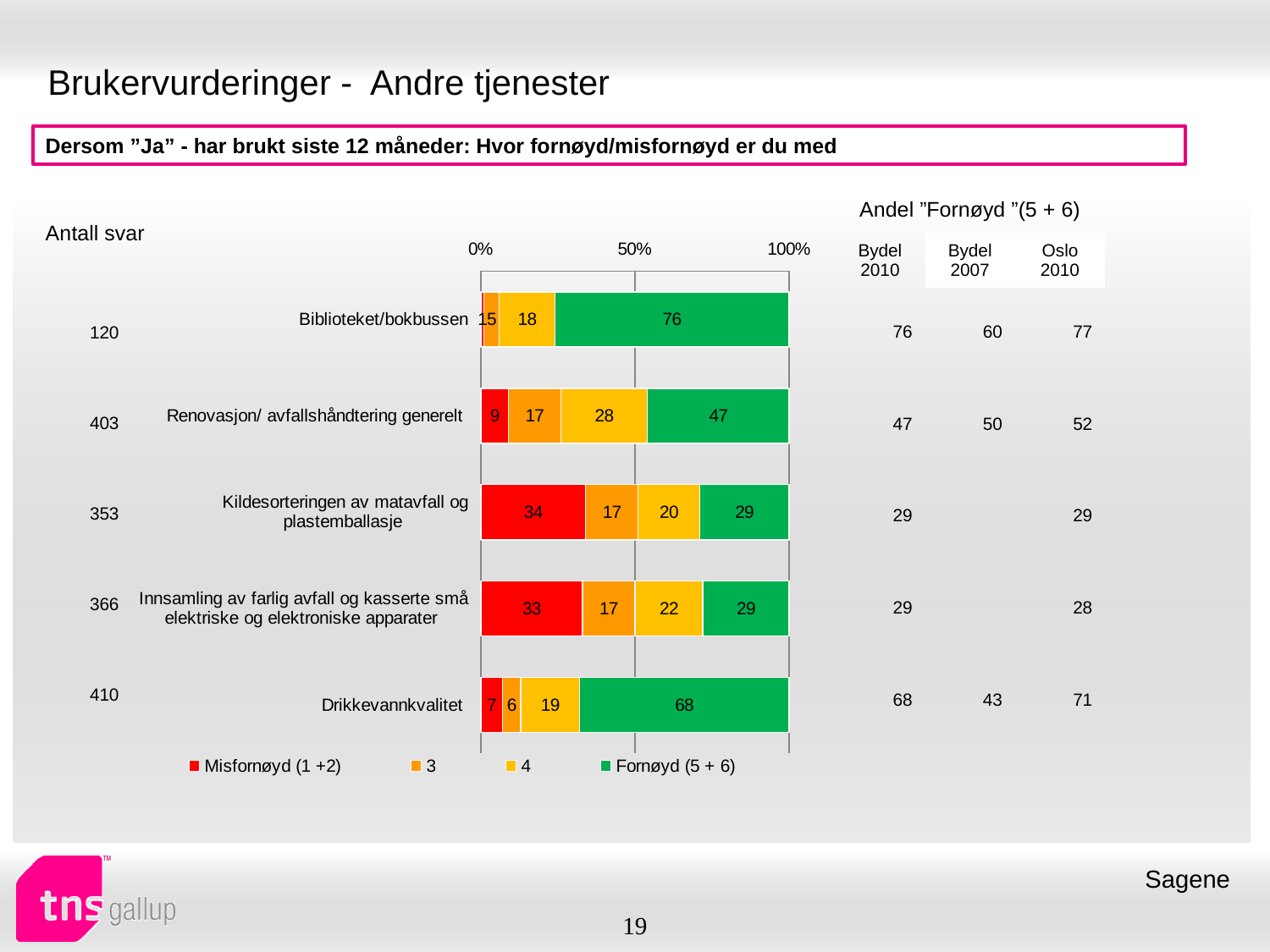
What is the value of the "4" series for Renovasjon/ avfallshåndtering generelt? 28 What kind of chart is shown on the slide? Stacked bar chart Which is larger: the "Fornøyd (5 + 6)" value for Renovasjon/ avfallshåndtering generelt or for Kildesorteringen av matavfall og plastemballasje? Renovasjon/ avfallshåndtering generelt Which category has the highest value for the "Fornøyd (5 + 6)" series? Biblioteket/bokbussen What is the value of the "Misfornøyd (1 +2)" series for Kildesorteringen av matavfall og plastemballasje? 34 What is the value of the "3" series for Drikkevannkvalitet? 6 What is the value of the "Fornøyd (5 + 6)" series for Biblioteket/bokbussen? 76 Which category has the lowest value for the "4" series? Biblioteket/bokbussen What is the difference between the "Fornøyd (5 + 6)" values for Biblioteket/bokbussen and Drikkevannkvalitet? 8 How many categories are shown in the chart? 5 Which legend entry is shown in green? Fornøyd (5 + 6) How many series does the legend list? 4